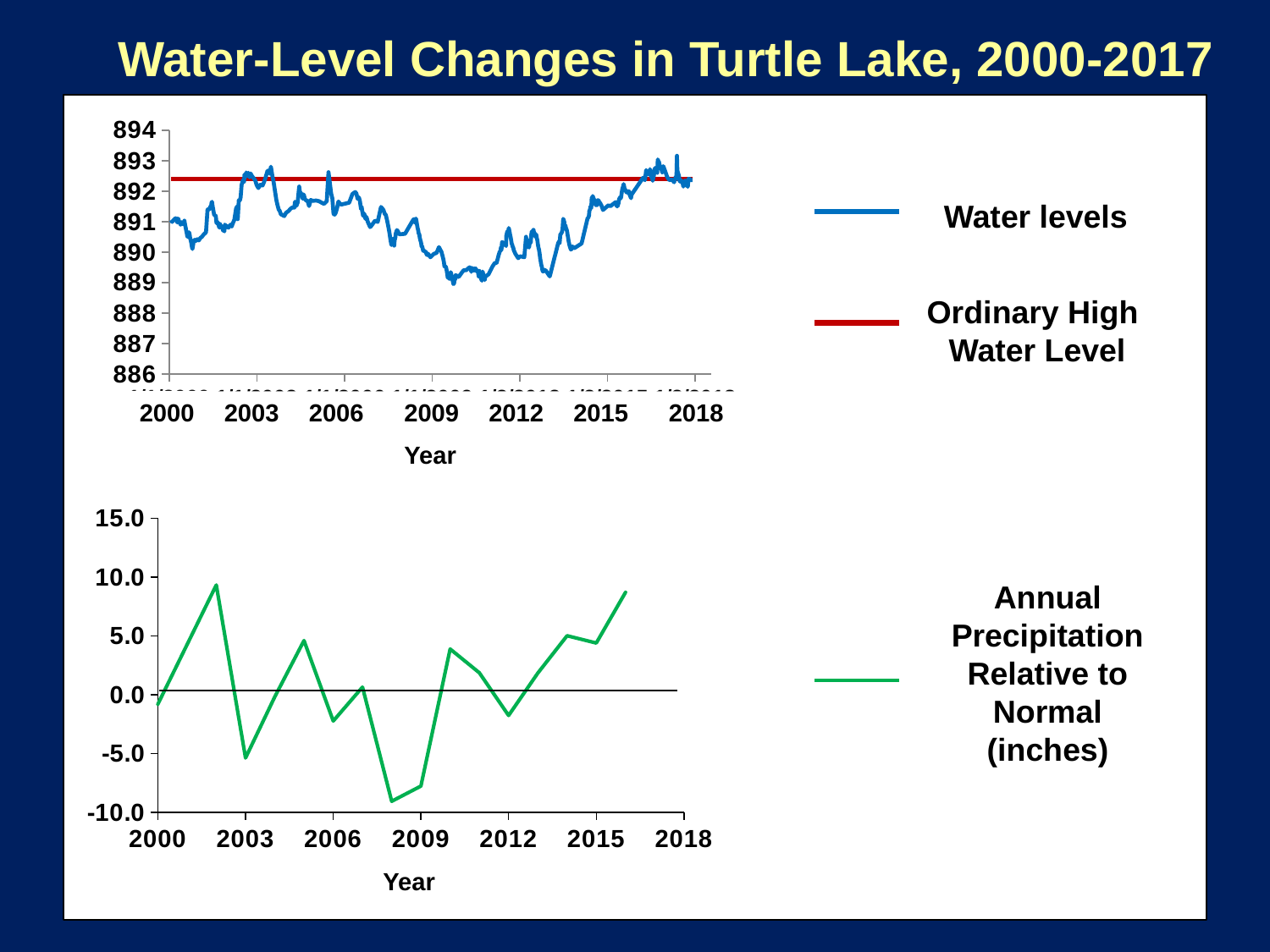
What is the x-axis label of the bottom chart? Year In the top chart, is the water level around 2010 greater or less than 890? less How many series does the legend of the top chart list? 2 In the bottom chart, is the annual precipitation relative to normal in 2002 greater or less than 5.0? greater In the bottom chart, in which year is annual precipitation relative to normal lowest? 2008 What are the two legend entries of the top chart? Water levels; Ordinary High Water Level In the bottom chart, does annual precipitation relative to normal rise or fall between 2012 and 2016? rise What kind of chart is the top chart on the slide? line chart In the top chart, do water levels rise or fall between 2003 and 2010? fall In the bottom chart, is the annual precipitation relative to normal in 2008 greater or less than -5.0? less In the top chart, is the water level higher in 2010 or in 2017? 2017